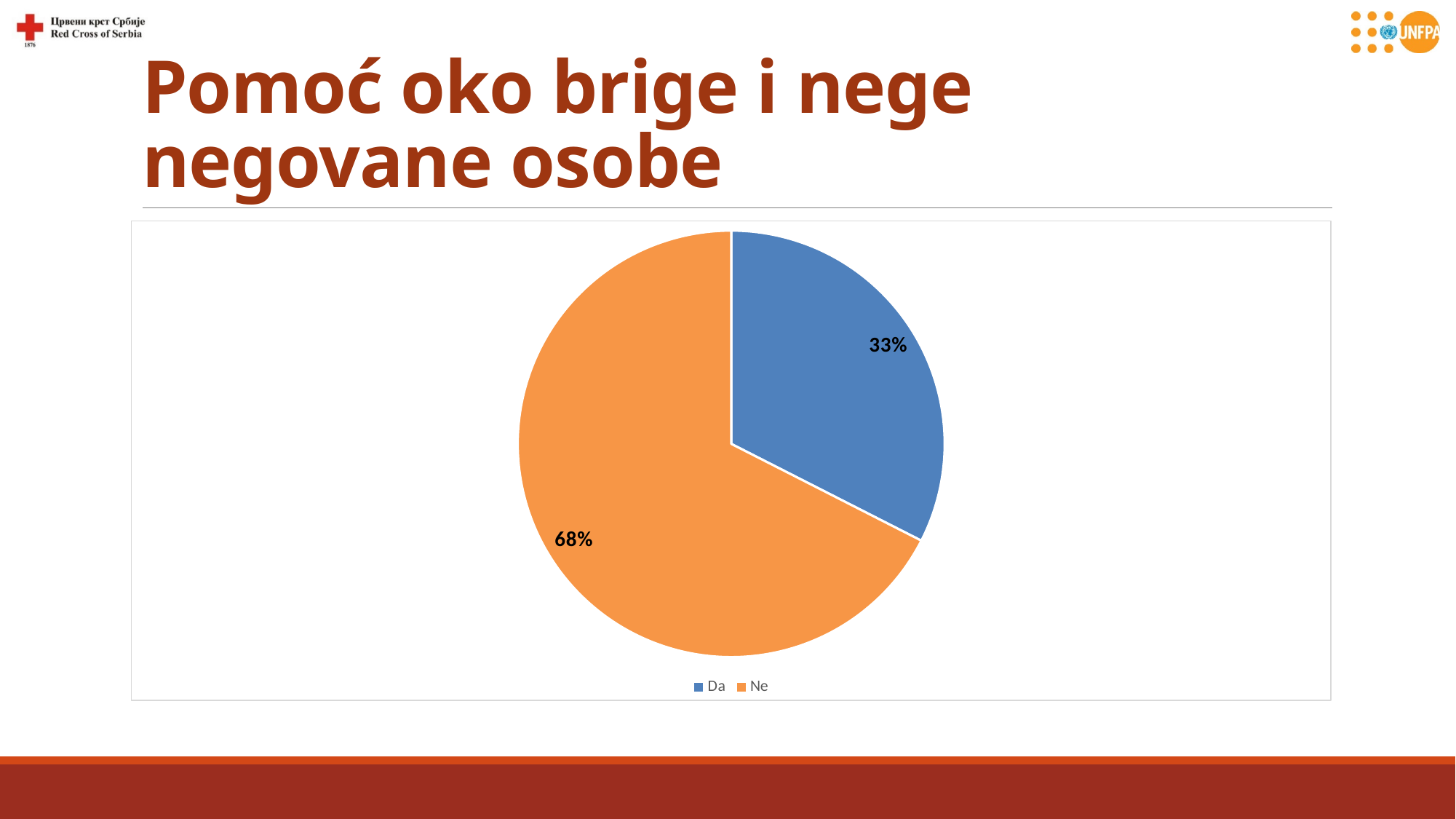
What percentage is shown for the "Ne" slice? 68% What colour is the "Da" slice? blue What colour is the "Ne" slice? orange What kind of chart is shown on the slide? pie chart Which slice is the smallest? Da How many slices does the pie chart have? 2 Which slice is the largest? Ne Which is larger, the "Da" slice or the "Ne" slice? Ne What is the difference in percentage points between the "Ne" slice and the "Da" slice? 35 What percentage is shown for the "Da" slice? 33% How many entries does the legend list? 2